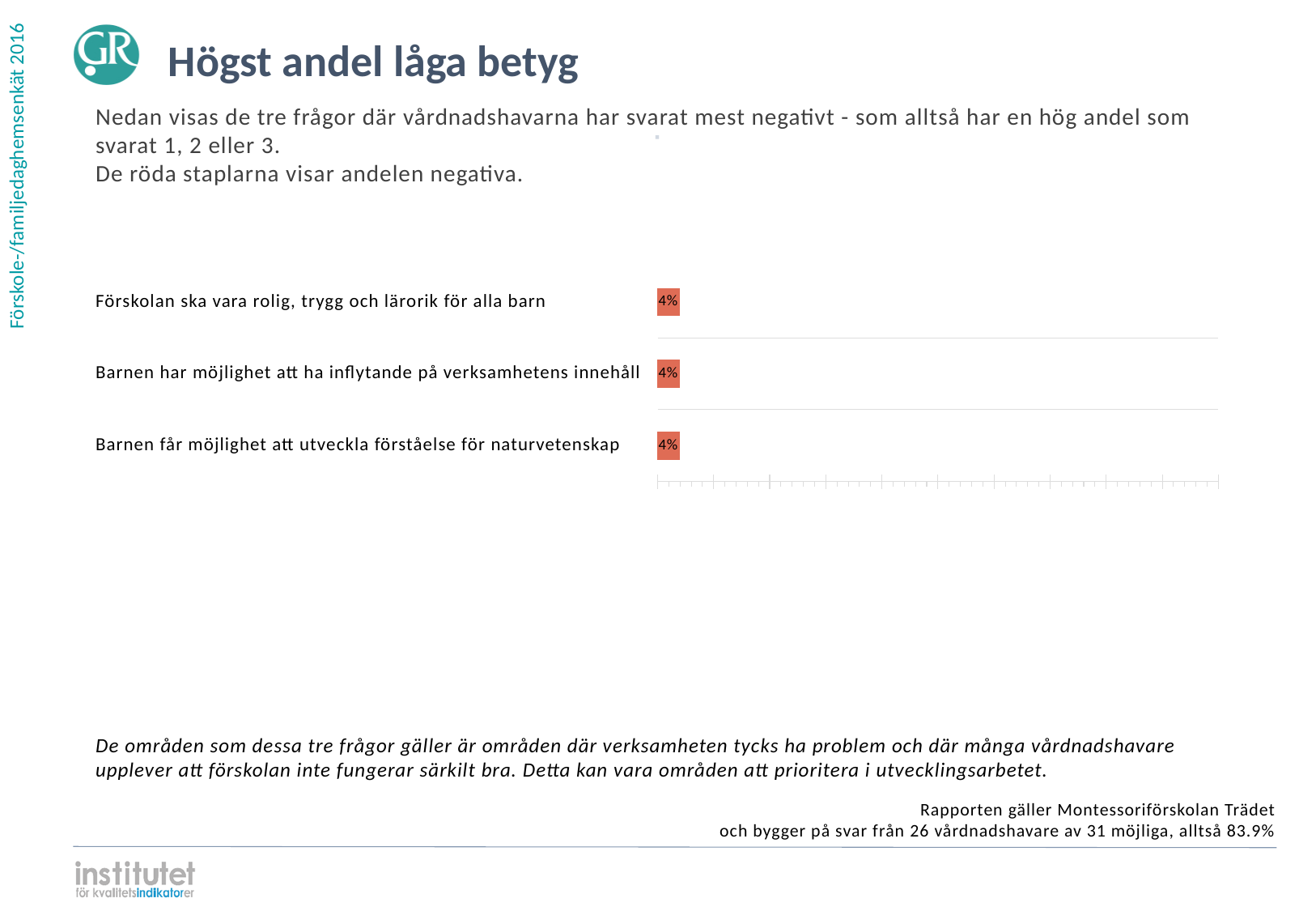
What is the title of the slide containing the chart? Högst andel låga betyg What colour are the bars in the chart? Red How many categories are shown in the chart? 3 What is the value for "Barnen har möjlighet att ha inflytande på verksamhetens innehåll"? 4% Is the value for "Barnen har möjlighet att ha inflytande på verksamhetens innehåll" larger than, smaller than, or equal to the value for "Barnen får möjlighet att utveckla förståelse för naturvetenskap"? Equal What is the value for "Förskolan ska vara rolig, trygg och lärorik för alla barn"? 4% What is the difference between the value for "Förskolan ska vara rolig, trygg och lärorik för alla barn" and the value for "Barnen får möjlighet att utveckla förståelse för naturvetenskap"? 0% What is the value for "Barnen får möjlighet att utveckla förståelse för naturvetenskap"? 4% What kind of chart is shown on the slide? Bar chart